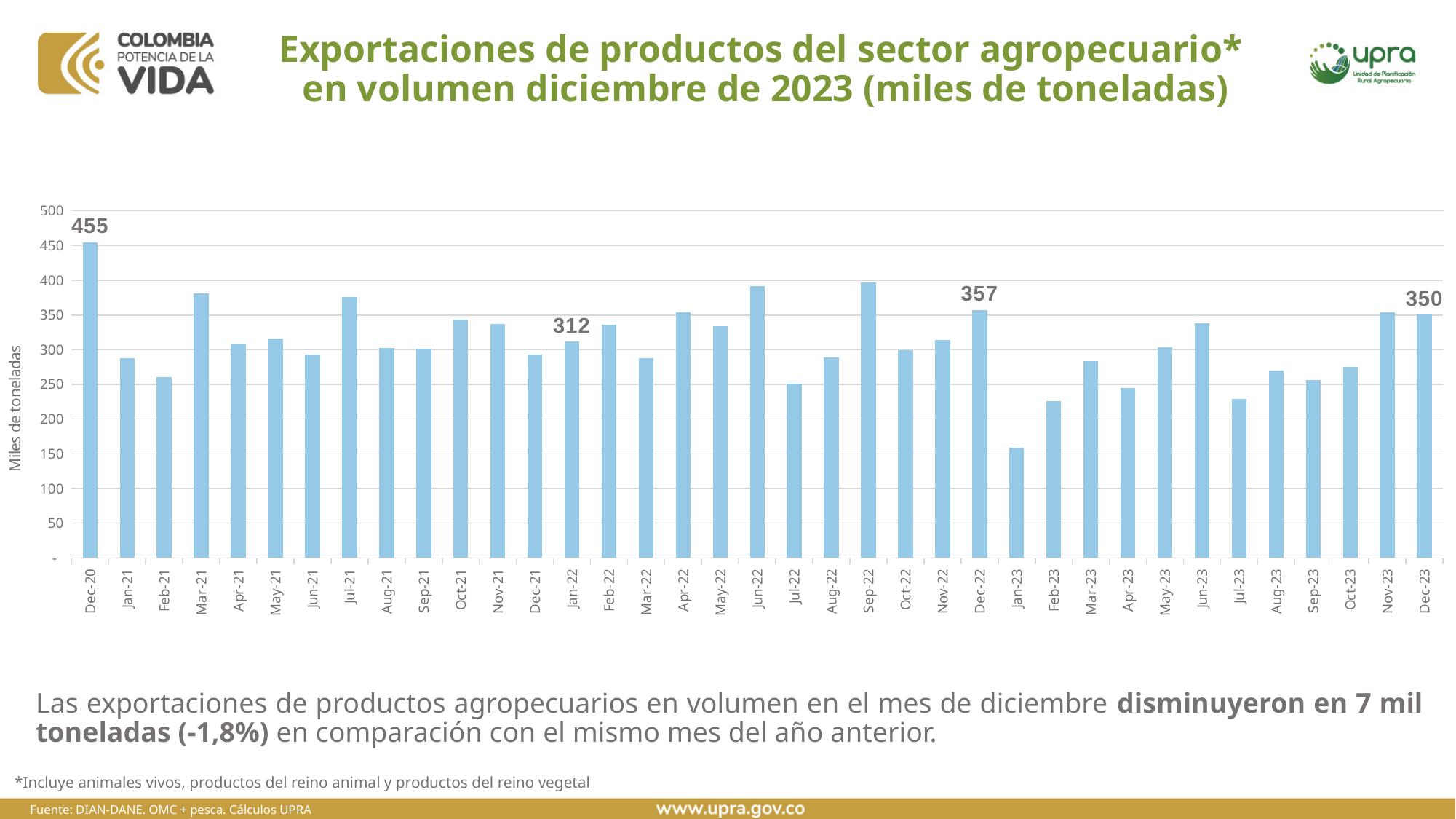
How many monthly bars are plotted in the chart? 37 Which month has the highest value in the chart? Dec-20 What is the difference between the values for Dec-20 and Dec-23? 105 What is the value for Jan-22? 312 What type of chart is shown on the slide? Bar chart Which is larger, the value for Dec-22 or the value for Dec-23? Dec-22 What is the difference between the values for Dec-22 and Dec-23? 7 Is the value for Jan-23 greater or less than 200? less Which month has the lowest value in the chart? Jan-23 What is the value for Dec-20? 455 What is the value for Dec-23? 350 What is the value for Dec-22? 357